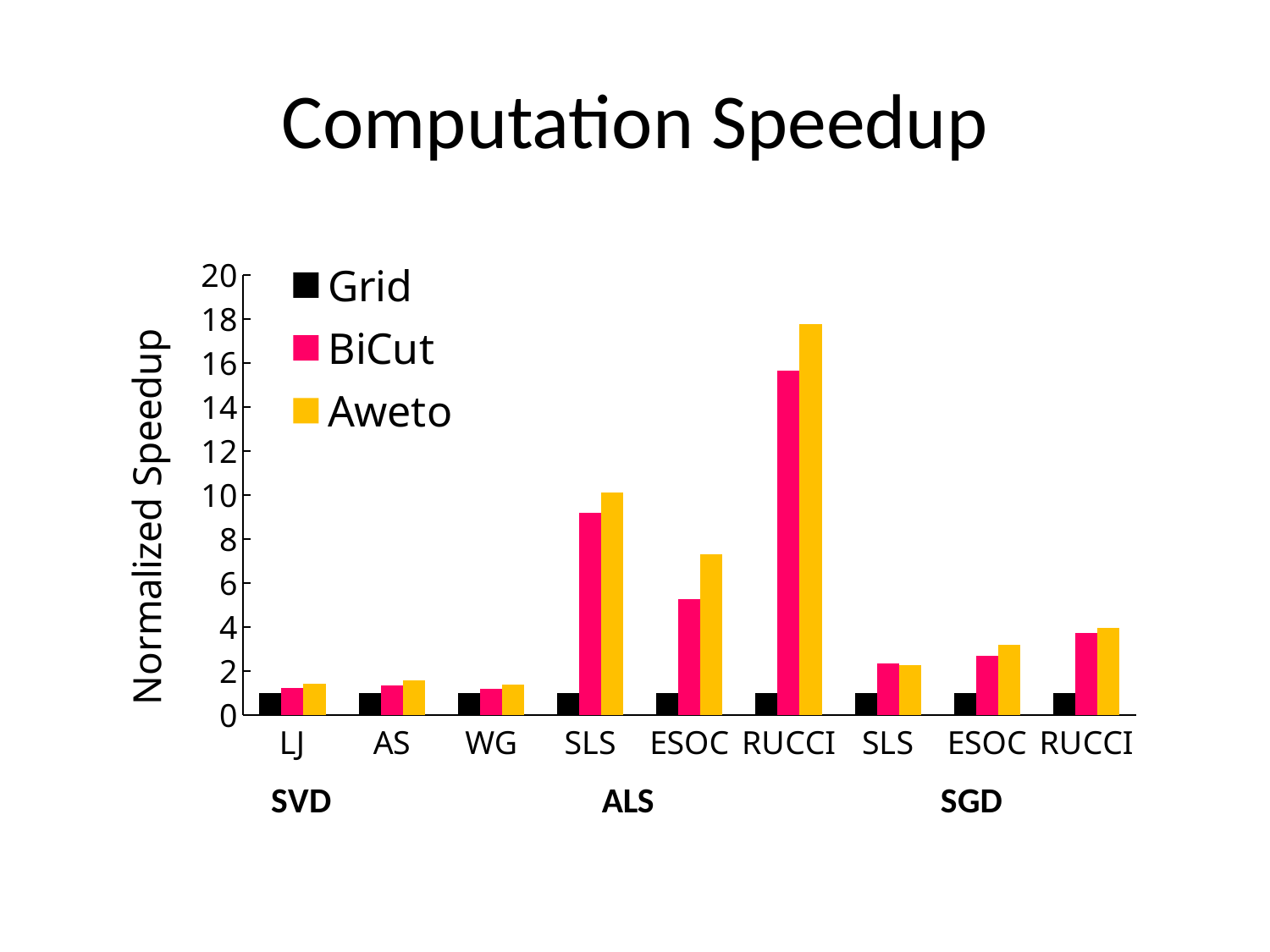
Is the Aweto value for RUCCI under ALS greater or less than 16? greater Which series and category has the highest normalized speedup? Aweto, RUCCI (ALS) Is the Aweto value for ESOC under ALS greater or less than 6? greater What is the label of the y axis? Normalized Speedup How many series does the legend list? 3 For Aweto, which is larger, the SLS value under ALS or the SLS value under SGD? SLS under ALS For ESOC under ALS, which is larger, the BiCut value or the Aweto value? Aweto Is the BiCut value for SLS under ALS greater or less than 10? less How many category groups are shown along the x axis? 9 What kind of chart is shown on the slide? bar chart